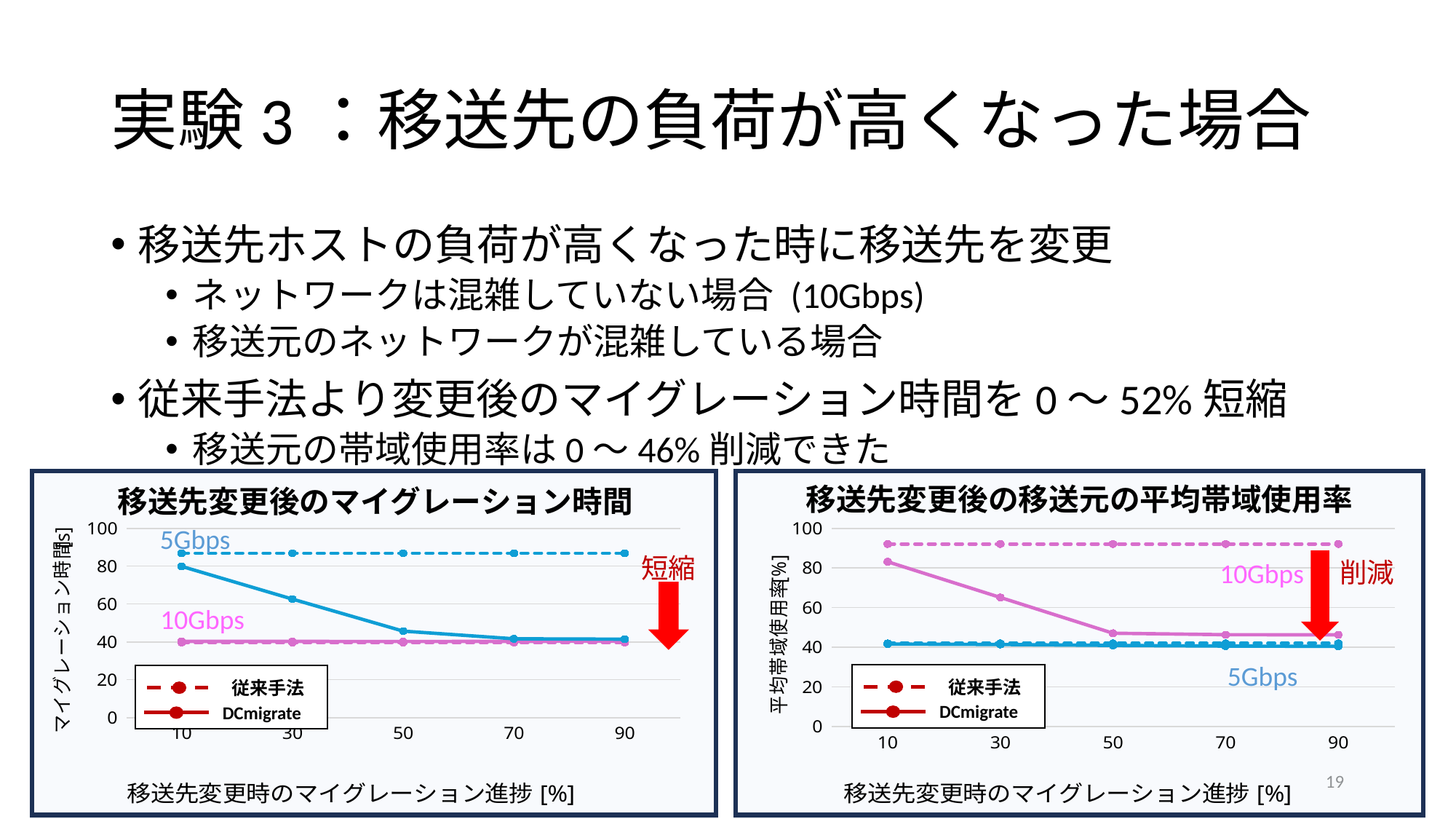
In the right chart (移送先変更後の移送元の平均帯域使用率), is the value of the solid 10Gbps DCmigrate line at 50% greater or less than 60? less In the right chart (移送先変更後の移送元の平均帯域使用率), at 10% progress, which is larger: the solid 10Gbps DCmigrate line or the solid 5Gbps DCmigrate line? 10Gbps DCmigrate In the left chart (移送先変更後のマイグレーション時間), is the value of the solid 5Gbps DCmigrate line at 50% greater or less than 60? less What is the x-axis label of the right chart (移送先変更後の移送元の平均帯域使用率)? 移送先変更時のマイグレーション進捗 [%] What kind of chart is the left chart titled 移送先変更後のマイグレーション時間? line chart In the right chart (移送先変更後の移送元の平均帯域使用率), how many series does the legend list? 2 In the left chart (移送先変更後のマイグレーション時間), how many points are plotted along the x axis for each line? 5 In the left chart (移送先変更後のマイグレーション時間), at 10% progress, which is larger: the solid 5Gbps DCmigrate line or the solid 10Gbps DCmigrate line? 5Gbps DCmigrate In the left chart (移送先変更後のマイグレーション時間), is the value of the solid 5Gbps DCmigrate line at 10% greater or less than 60? greater In the left chart (移送先変更後のマイグレーション時間), does the solid 5Gbps DCmigrate line rise or fall as the migration progress increases from 10 to 90? fall